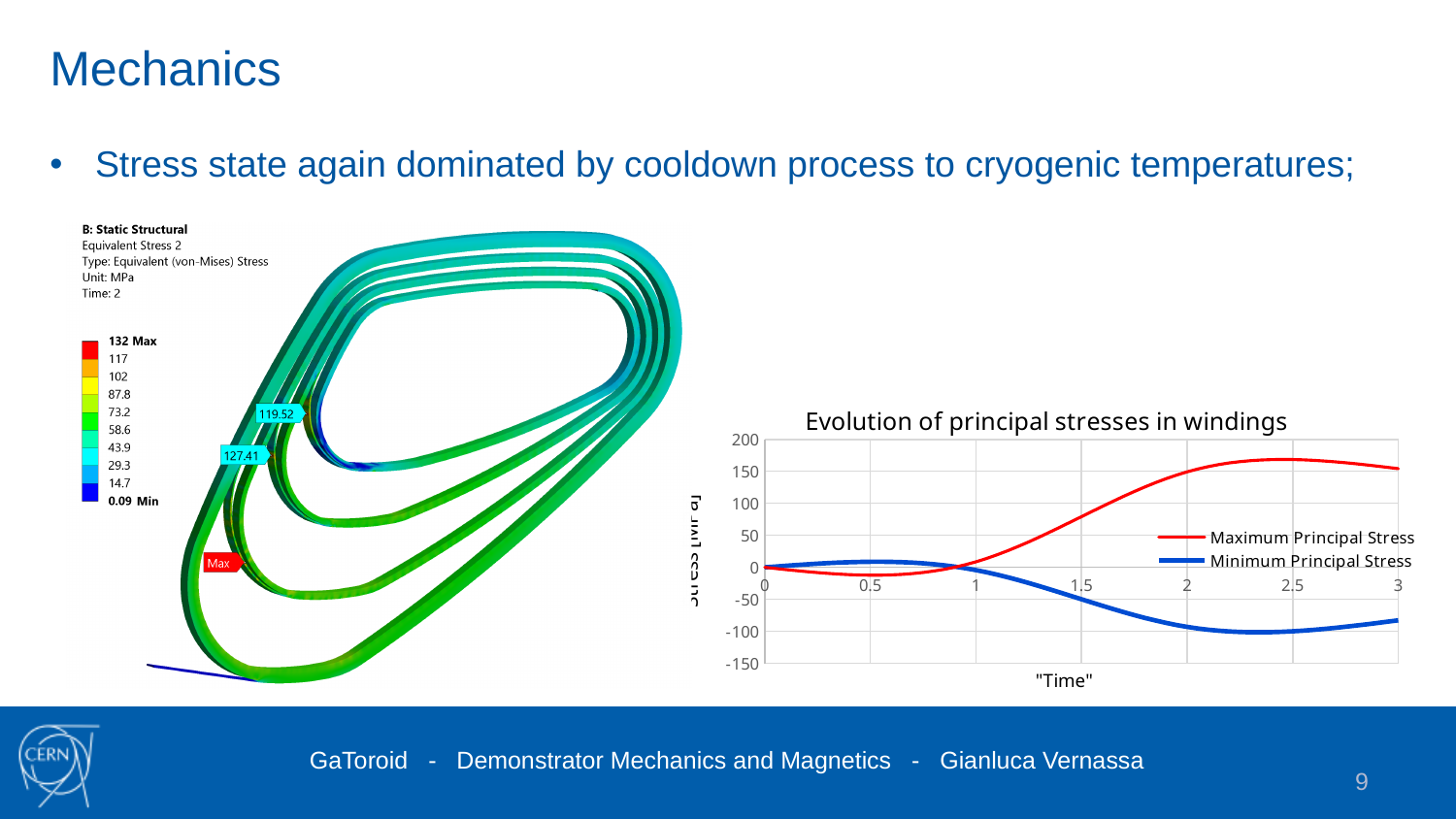
In the "Evolution of principal stresses in windings" chart, is the Maximum Principal Stress at time 2.5 greater or less than 150? greater In the "Evolution of principal stresses in windings" chart, is the Minimum Principal Stress at time 2.5 greater or less than -50? less In the "Evolution of principal stresses in windings" chart, what colour is the Minimum Principal Stress line? blue What kind of chart is "Evolution of principal stresses in windings"? line chart In the "Evolution of principal stresses in windings" chart, is the Maximum Principal Stress at time 0.5 greater or less than 50? less What are the two series named in the legend of the "Evolution of principal stresses in windings" chart? Maximum Principal Stress and Minimum Principal Stress How many series does the legend of the "Evolution of principal stresses in windings" chart list? 2 In the "Evolution of principal stresses in windings" chart, does the Minimum Principal Stress rise or fall between time 1 and time 2? fall In the "Evolution of principal stresses in windings" chart, does the Maximum Principal Stress rise or fall between time 1 and time 2? rise In the "Evolution of principal stresses in windings" chart, which series has the higher value at time 2? Maximum Principal Stress